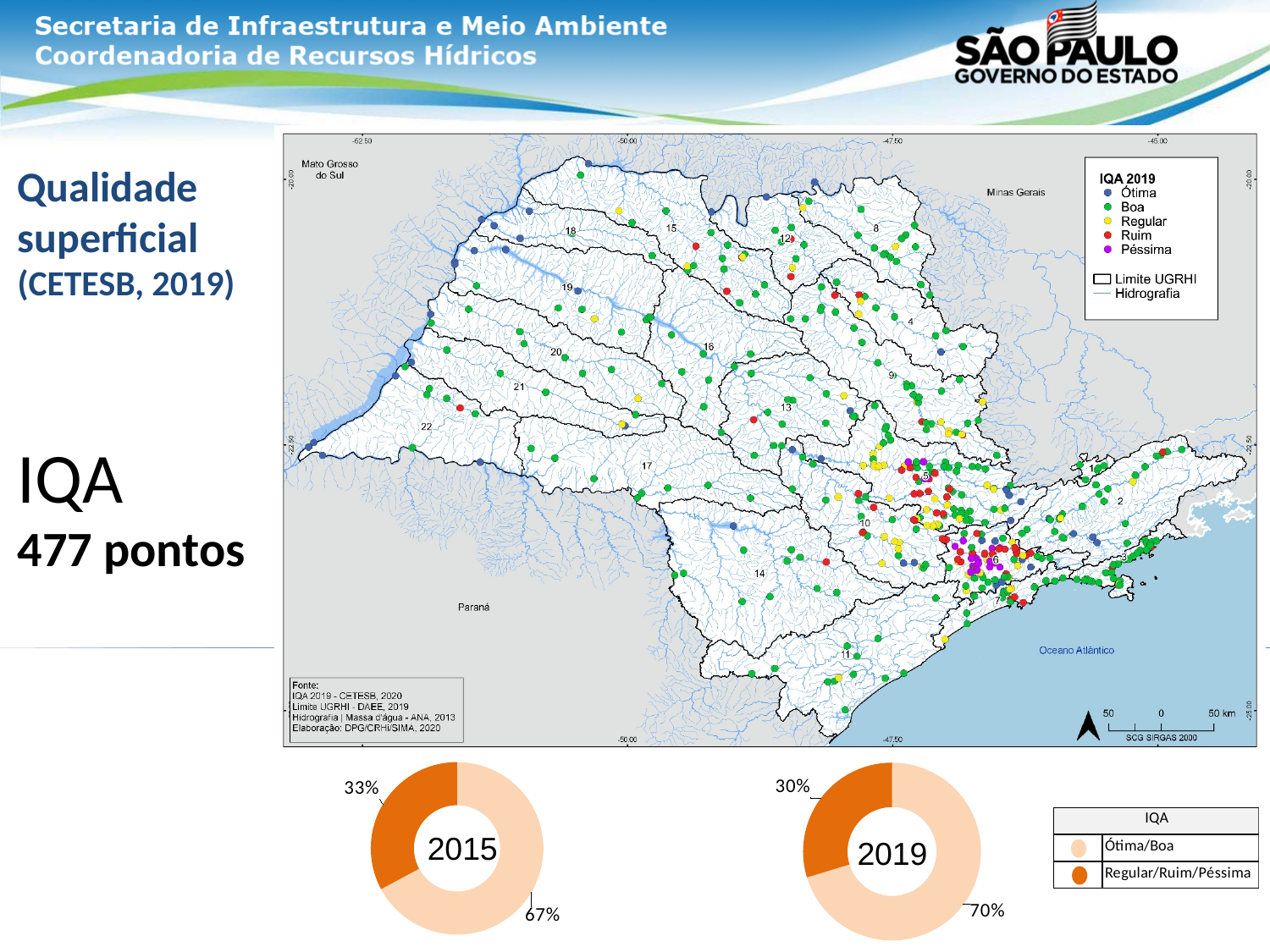
In the 2015 donut chart, what share is Regular/Ruim/Péssima? 33% How many donut charts are shown on the slide? 2 What is the difference between the Ótima/Boa share in 2019 and in 2015? 3% In the 2019 donut chart, what share is Ótima/Boa? 70% In the 2019 donut chart, which category has the largest share? Ótima/Boa In the 2015 donut chart, what share is Ótima/Boa? 67% In the 2019 donut chart, what share is Regular/Ruim/Péssima? 30% In the donut charts, which colour represents Regular/Ruim/Péssima? Dark orange How many categories does the IQA legend for the donut charts list? 2 What kind of chart is used to show the 2015 and 2019 IQA shares? Donut (pie) chart Is the Regular/Ruim/Péssima share larger in the 2015 chart or the 2019 chart? 2015 In the 2015 donut chart, which category has the smallest share? Regular/Ruim/Péssima